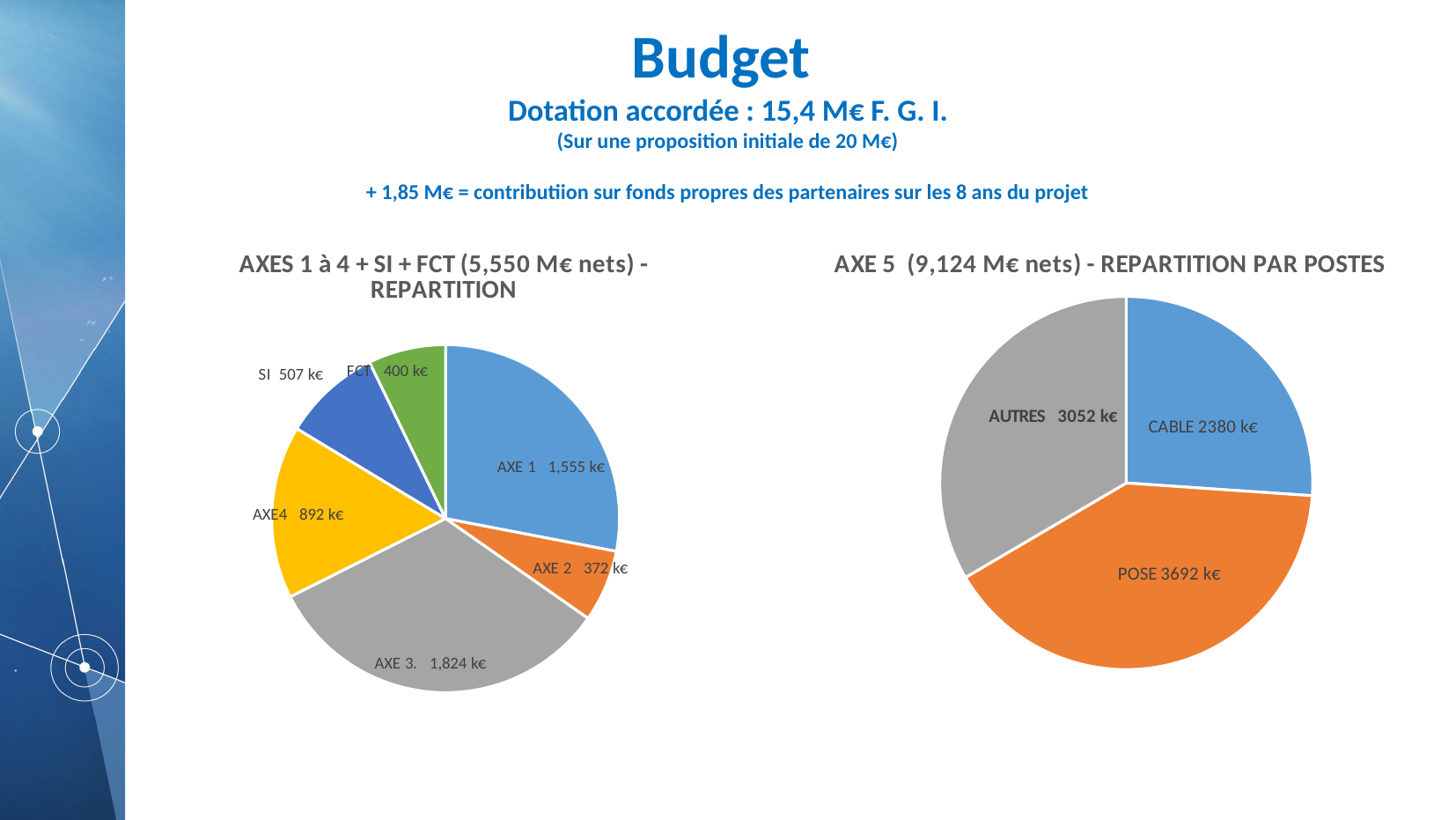
In the right pie chart (AXE 5 - REPARTITION PAR POSTES), how much larger is POSE than CABLE? 1312 k€ In the left pie chart (AXES 1 à 4 + SI + FCT), which category has the largest value? AXE 3 In the right pie chart (AXE 5 - REPARTITION PAR POSTES), what is the value for POSE? 3692 k€ In the right pie chart (AXE 5 - REPARTITION PAR POSTES), what is the value for CABLE? 2380 k€ In the left pie chart (AXES 1 à 4 + SI + FCT), what is the difference between AXE 3 and AXE 1? 269 k€ What type of chart is used for AXE 5 - REPARTITION PAR POSTES? Pie chart In the left pie chart (AXES 1 à 4 + SI + FCT), which category has the smallest value? AXE 2 In the right pie chart (AXE 5 - REPARTITION PAR POSTES), which poste has the smallest value? CABLE How many slices does the left pie chart (AXES 1 à 4 + SI + FCT) have? 6 In the left pie chart (AXES 1 à 4 + SI + FCT), which is larger, AXE4 or SI? AXE4 In the left pie chart (AXES 1 à 4 + SI + FCT), what is the value for SI? 507 k€ In the left pie chart (AXES 1 à 4 + SI + FCT), what is the value for AXE 1? 1,555 k€